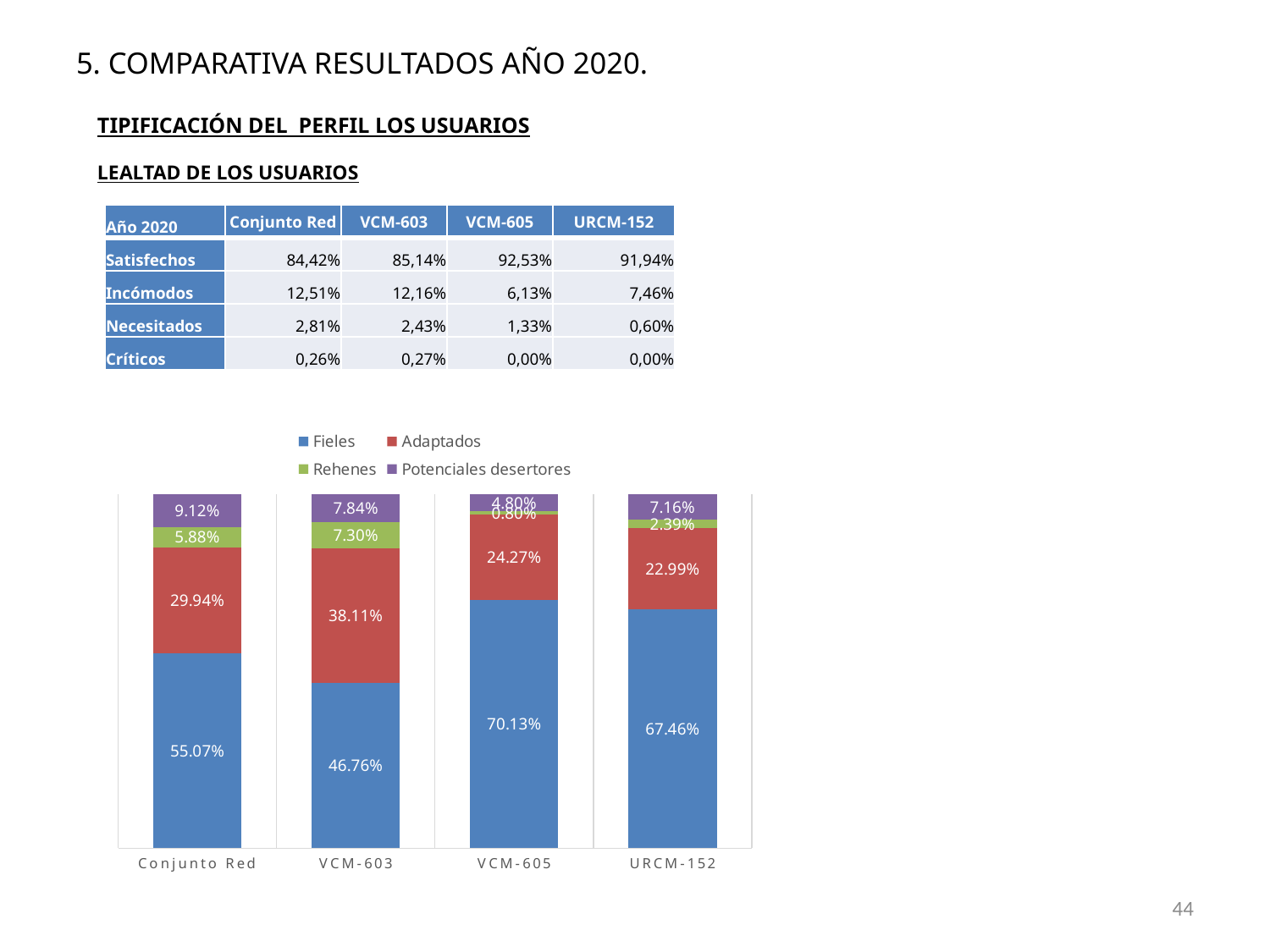
Which category has the highest Fieles value in the chart? VCM-605 What is the difference between the Fieles values for VCM-605 and URCM-152 in the chart? 2.67% Is the Adaptados value larger for VCM-603 or for URCM-152 in the chart? VCM-603 What type of chart is shown on the slide? stacked bar chart How many series does the chart legend list? 4 Which category has the lowest Fieles value in the chart? VCM-603 What is the Rehenes value for VCM-603 in the chart? 7.30% How many categories are shown on the x axis of the chart? 4 What is the Fieles value for VCM-603 in the chart? 46.76% What is the Potenciales desertores value for URCM-152 in the chart? 7.16% Which series is shown in blue in the chart? Fieles What is the Adaptados value for Conjunto Red in the chart? 29.94%